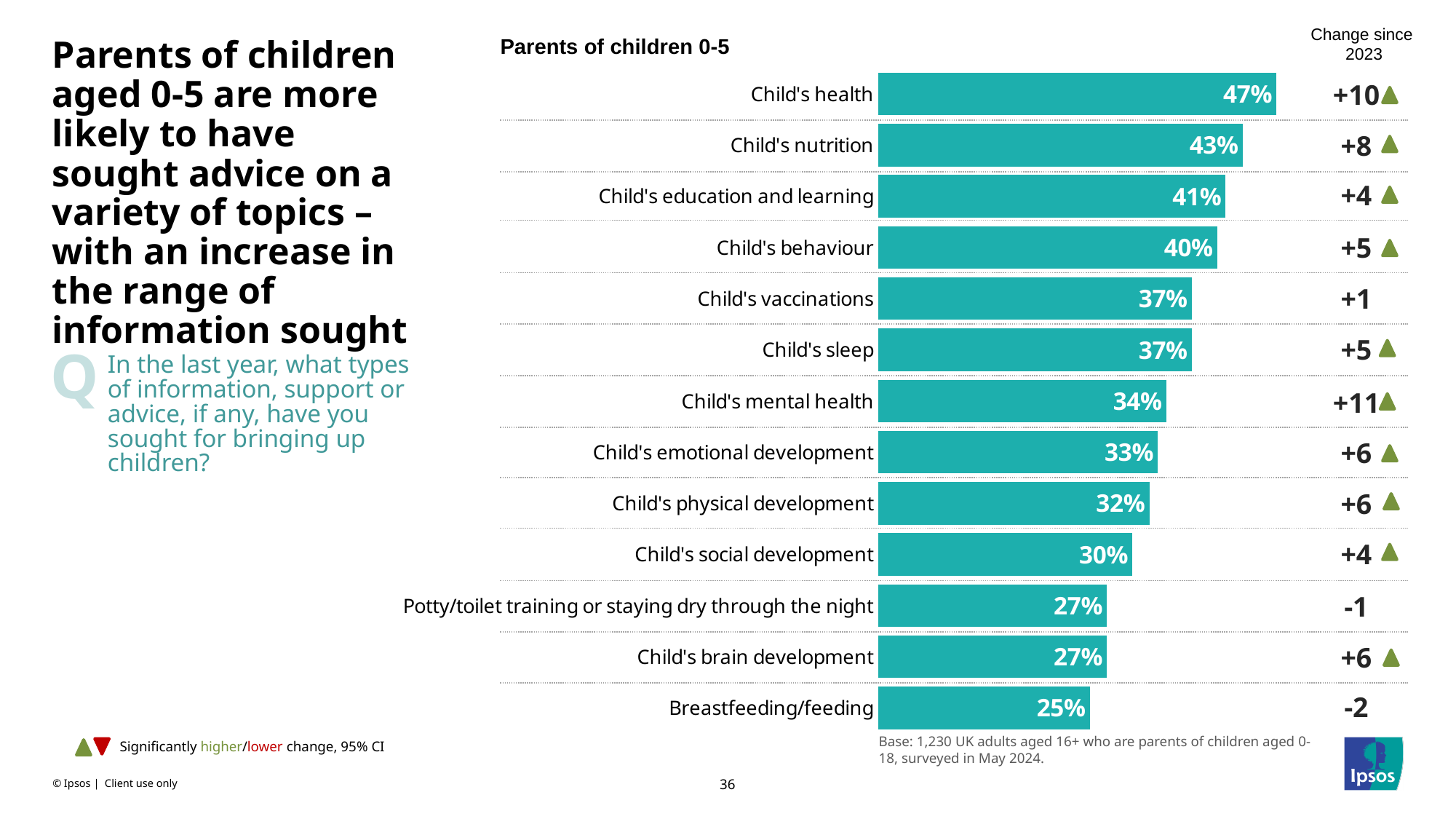
What kind of chart is shown on the slide? Bar chart What is the title of the chart? Parents of children 0-5 Which is larger: the value for child's education and learning or the value for child's sleep? Child's education and learning What percentage of parents of children 0-5 sought advice on breastfeeding/feeding? 25% What is the difference in percentage points between child's health and child's nutrition? 4 How many topics are shown in the chart? 13 What percentage of parents of children 0-5 sought advice on child's mental health? 34% Which topic has the lowest percentage in the chart? Breastfeeding/feeding What percentage of parents of children 0-5 sought advice on child's health? 47% Which topic has the highest percentage in the chart? Child's health What is the difference in percentage points between child's behaviour and child's social development? 10 What is the change since 2023 shown for child's mental health? +11